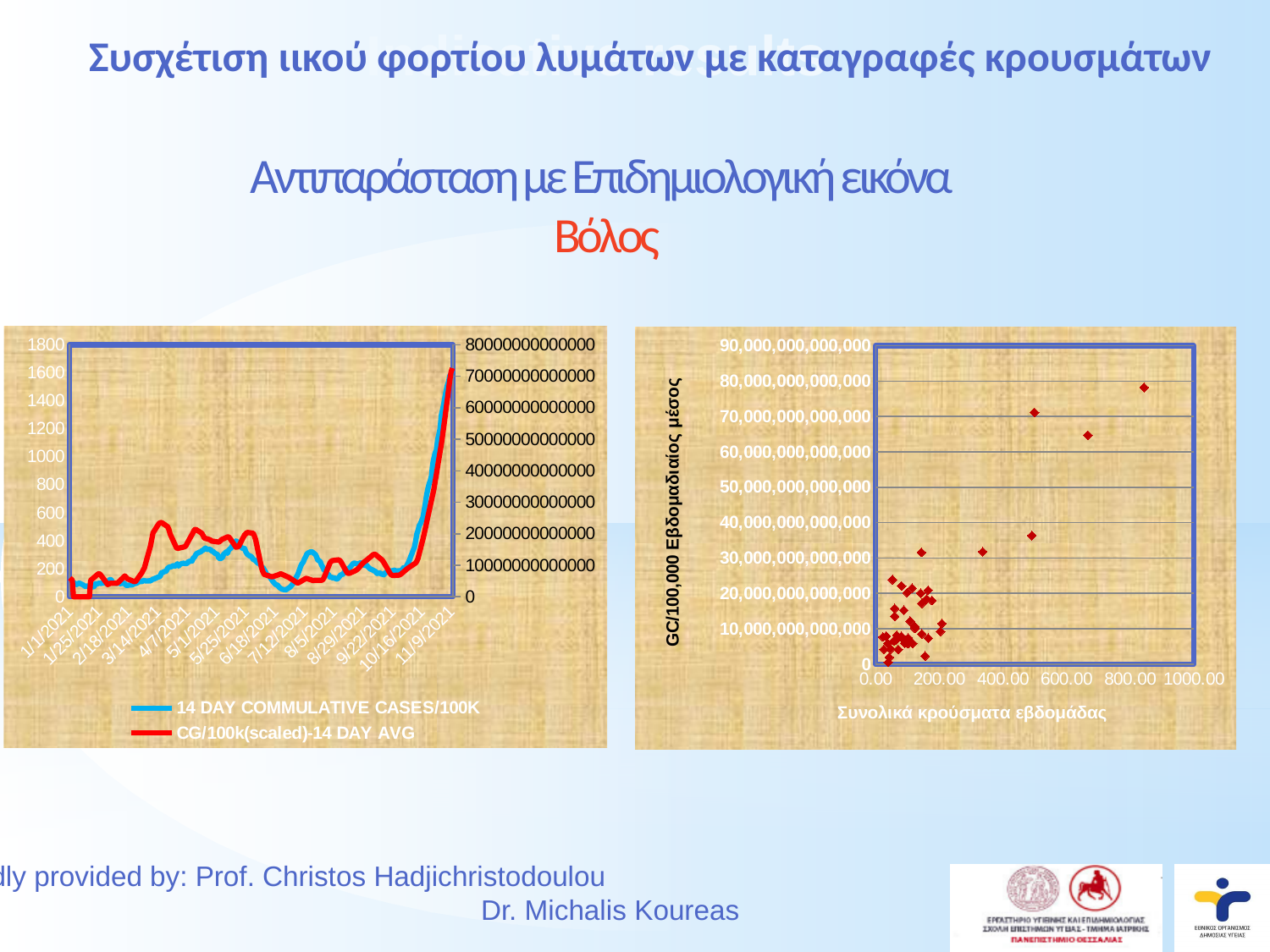
In the right chart, is the y value of the highest point greater or less than 70,000,000,000,000? greater In the left chart, what is the last date label on the x axis? 11/9/2021 In the left chart, what is the highest tick value shown on the left vertical axis? 1800 In the right chart, what is the highest tick value shown on the x axis? 1000.00 What kind of chart is the chart on the right of the slide? scatter chart In the left chart, which series is drawn in blue according to the legend? 14 DAY COMMULATIVE CASES/100K In the left chart, what is the first date label on the x axis? 1/1/2021 In the left chart, do both series rise or fall over the final dates on the x axis (from 10/16/2021 to 11/9/2021)? rise In the left chart, which series is drawn in red according to the legend? CG/100k(scaled)-14 DAY AVG How many series does the legend of the left chart list? 2 In the right chart, how many points lie above the 60,000,000,000,000 gridline? 3 What kind of chart is the chart on the left of the slide? line chart